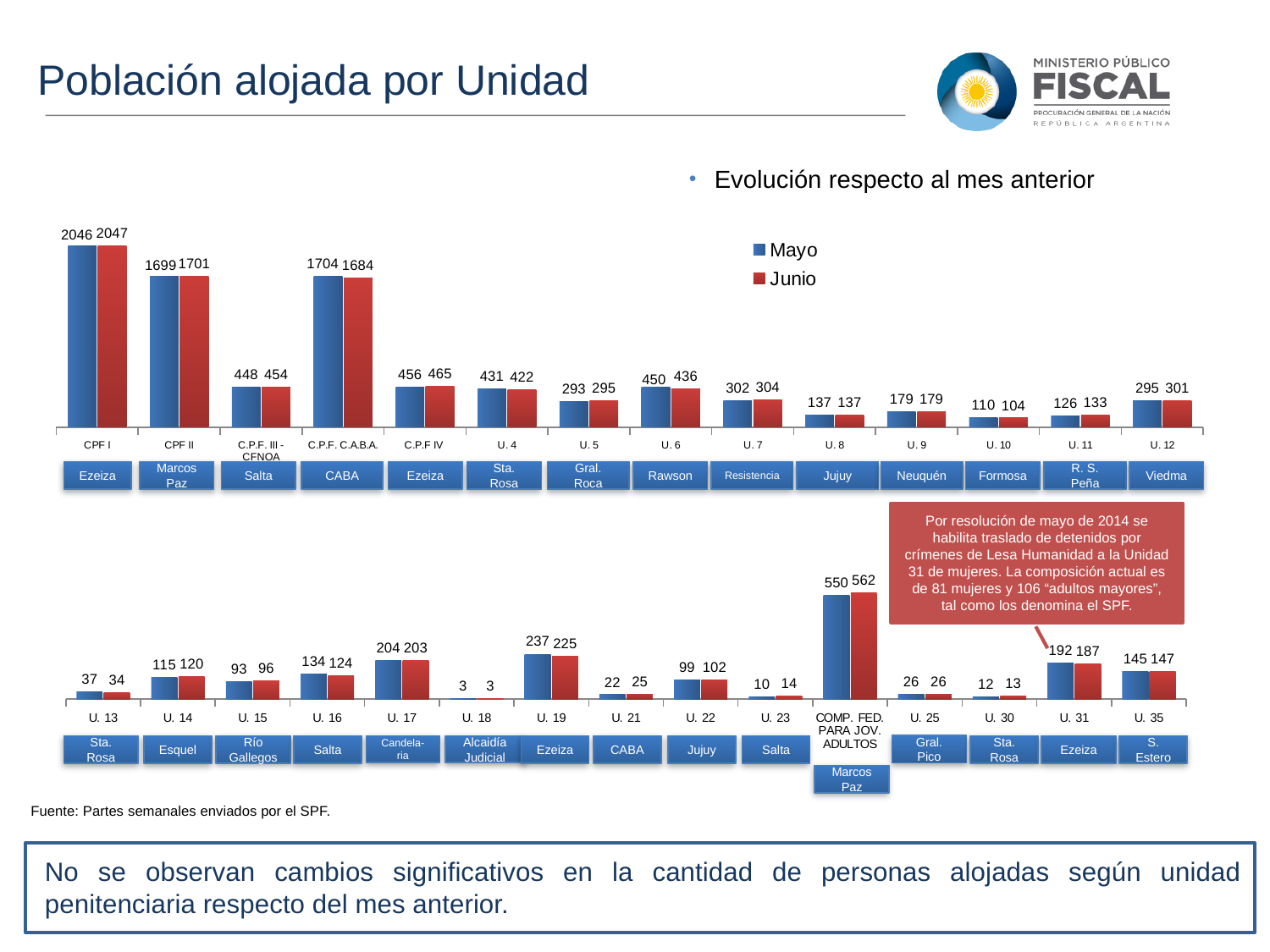
In the bottom chart, which category has the lowest Mayo value? U. 18 How many categories are shown in the bottom chart? 15 What type of chart is the top chart? Bar chart In the top chart, which category has the highest Mayo value? CPF I In the top chart, what is the difference between the Mayo and Junio values for C.P.F. C.A.B.A.? 20 In the bottom chart, what is the difference between the Junio and Mayo values for U. 16? 10 In the bottom chart, which is larger: the Mayo value for U. 19 or the Mayo value for U. 31? U. 19 In the top chart, how many series does the legend list? 2 In the bottom chart, what is the Junio value for COMP. FED. PARA JOV. ADULTOS? 562 In the top chart, which category has the lowest Junio value? U. 10 In the top chart, what is the Mayo value for U. 6? 450 In the top chart, what is the Junio value for CPF I? 2047